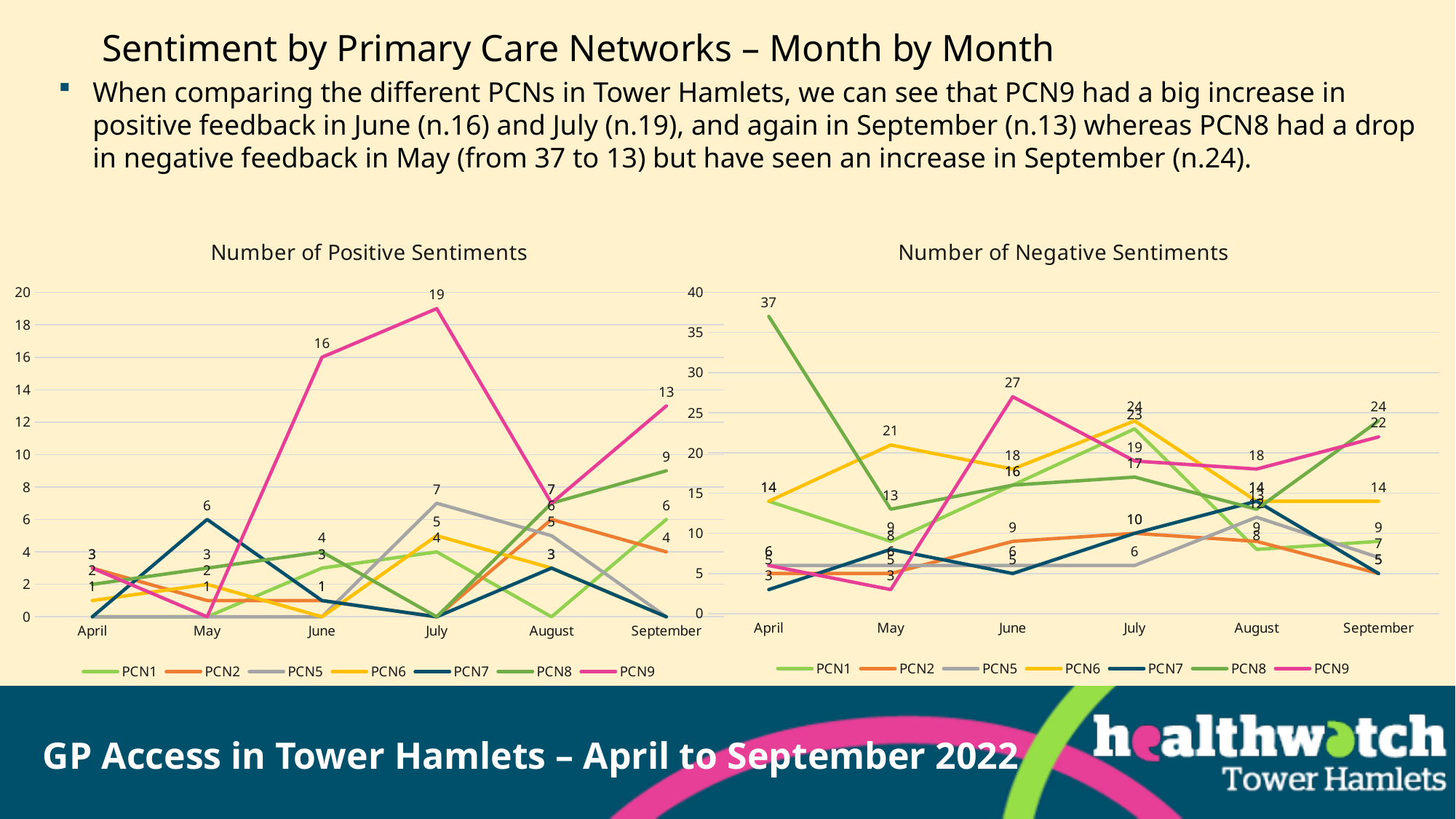
On the Number of Positive Sentiments chart, what is the value for PCN9 in June? 16 On the Number of Positive Sentiments chart, by how much did PCN9 increase from June to July? 3 On the Number of Positive Sentiments chart, what value does PCN9 reach in July? 19 On the Number of Negative Sentiments chart, what is the value for PCN8 in April? 37 On the Number of Positive Sentiments chart, which series has the highest value in July? PCN9 What kind of chart is the Number of Positive Sentiments chart? Line chart On the Number of Negative Sentiments chart, which series has the highest value in April? PCN8 On the Number of Positive Sentiments chart, what is the value for PCN7 in May? 6 On the Number of Negative Sentiments chart, what is the difference between PCN8's April value and its May value? 24 How many months are shown on the x axis of the Number of Negative Sentiments chart? 6 How many series does the legend of the Number of Positive Sentiments chart list? 7 On the Number of Negative Sentiments chart, what is the value for PCN9 in June? 27